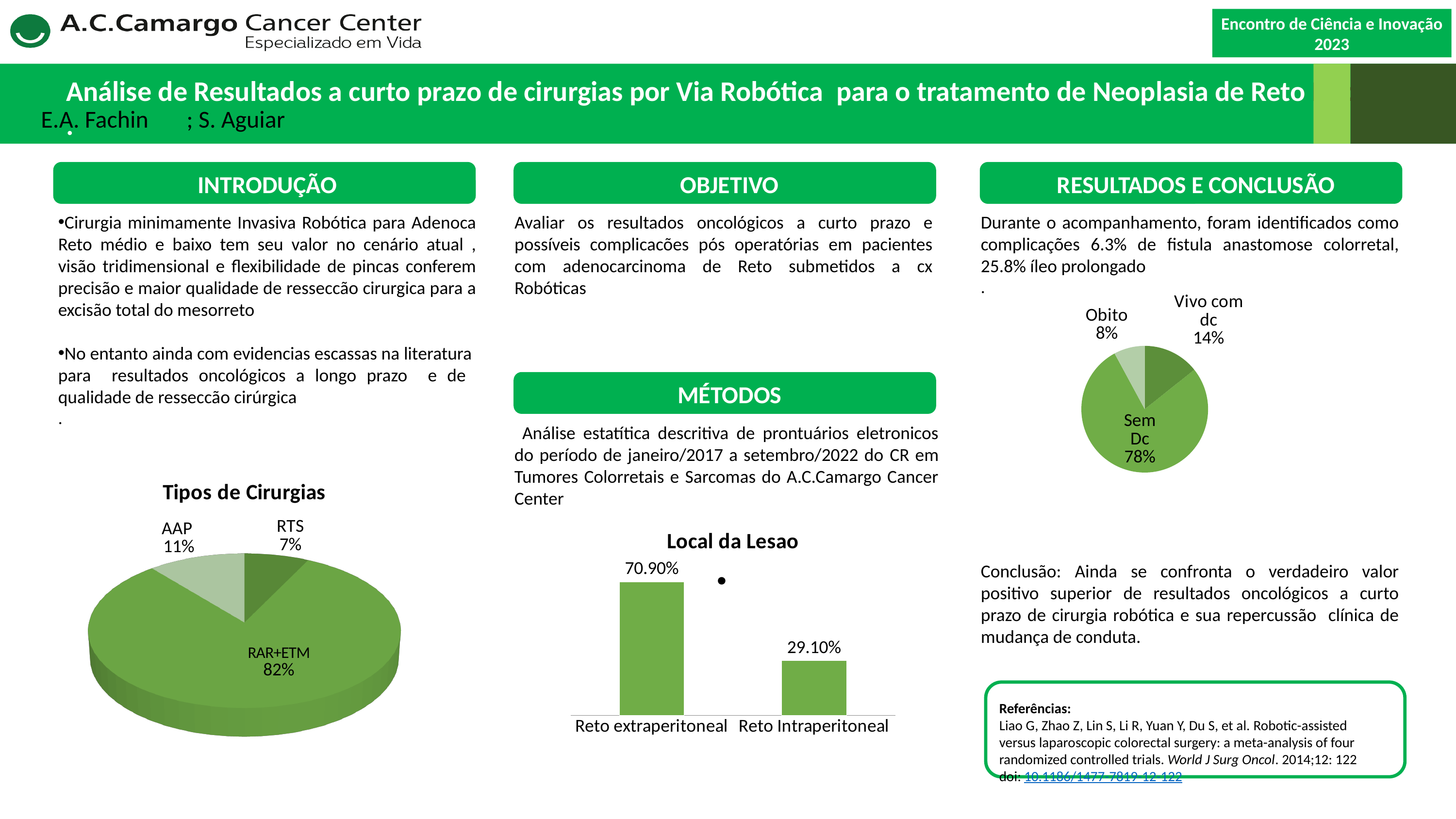
In the 'Local da Lesao' chart, what is the difference between Reto extraperitoneal and Reto Intraperitoneal? 41.80% In the 'Local da Lesao' chart, what is the value for Reto extraperitoneal? 70.90% In the 'Tipos de Cirurgias' chart, which category has the smallest slice? RTS What kind of chart is 'Local da Lesao'? Bar chart What kind of chart is 'Tipos de Cirurgias'? Pie chart In the pie chart on the right side of the slide, which category has the smallest slice? Obito In the 'Tipos de Cirurgias' chart, how many slices are there? 3 In the 'Tipos de Cirurgias' chart, what share does RAR+ETM have? 82% In the 'Local da Lesao' chart, what is the value for Reto Intraperitoneal? 29.10% In the pie chart on the right side of the slide, what is the difference between Vivo com dc and Obito? 6% In the 'Tipos de Cirurgias' chart, what share does AAP have? 11% In the pie chart on the right side of the slide, what share does Sem Dc have? 78%